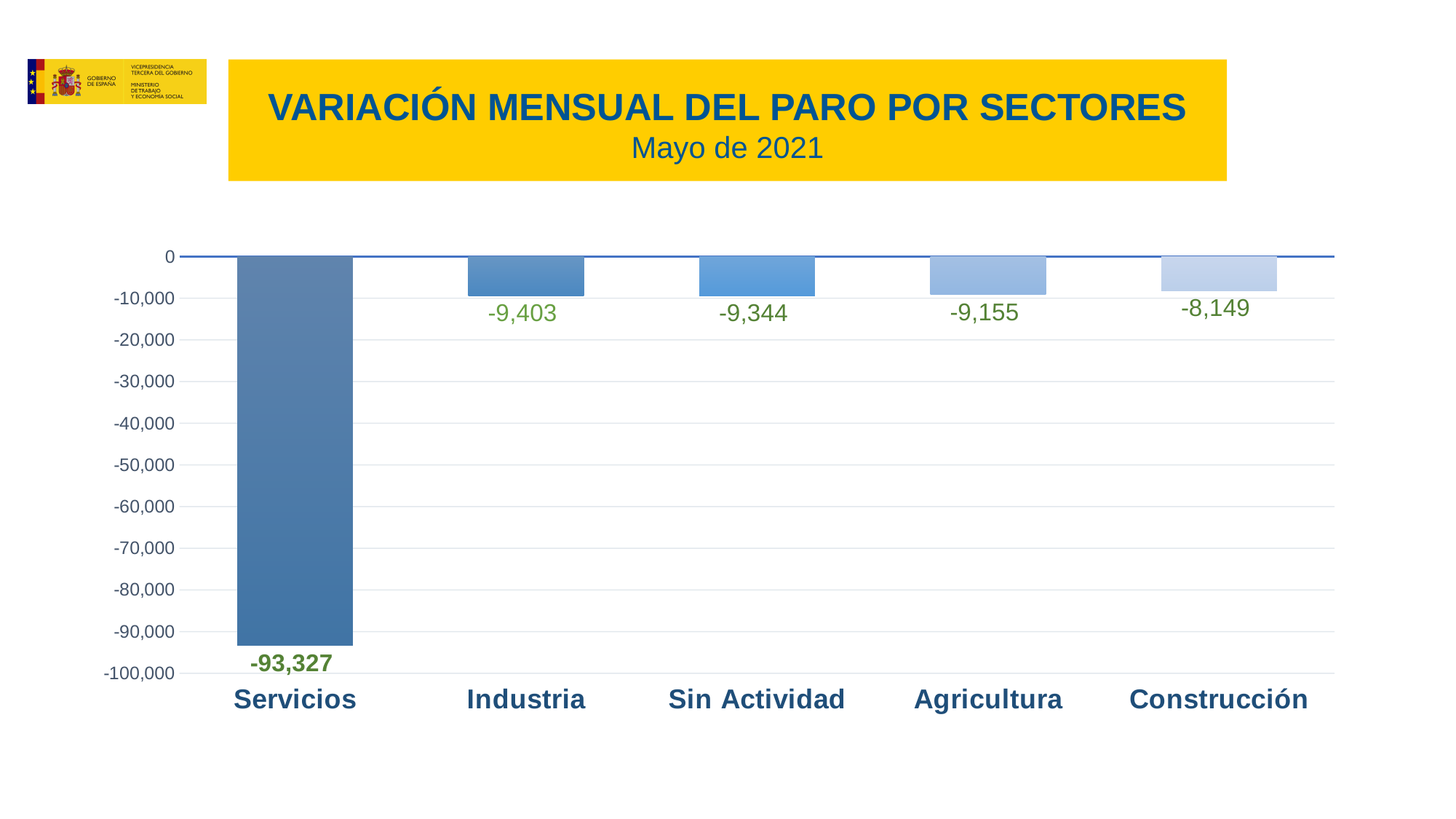
Which has a larger (less negative) value, Industria or Sin Actividad? Sin Actividad How many sectors are shown in the chart? 5 What is the value for Agricultura? -9,155 What is the difference between the values for Servicios and Construcción? 85,178 Which sector has the highest (least negative) value? Construcción What is the value for Servicios? -93,327 What is the difference between the values for Industria and Sin Actividad? 59 Is the value for Servicios greater or less than -90,000? less What kind of chart is shown on the slide? Bar chart What is the value for Construcción? -8,149 What is the value for Industria? -9,403 Which sector has the lowest (most negative) value? Servicios